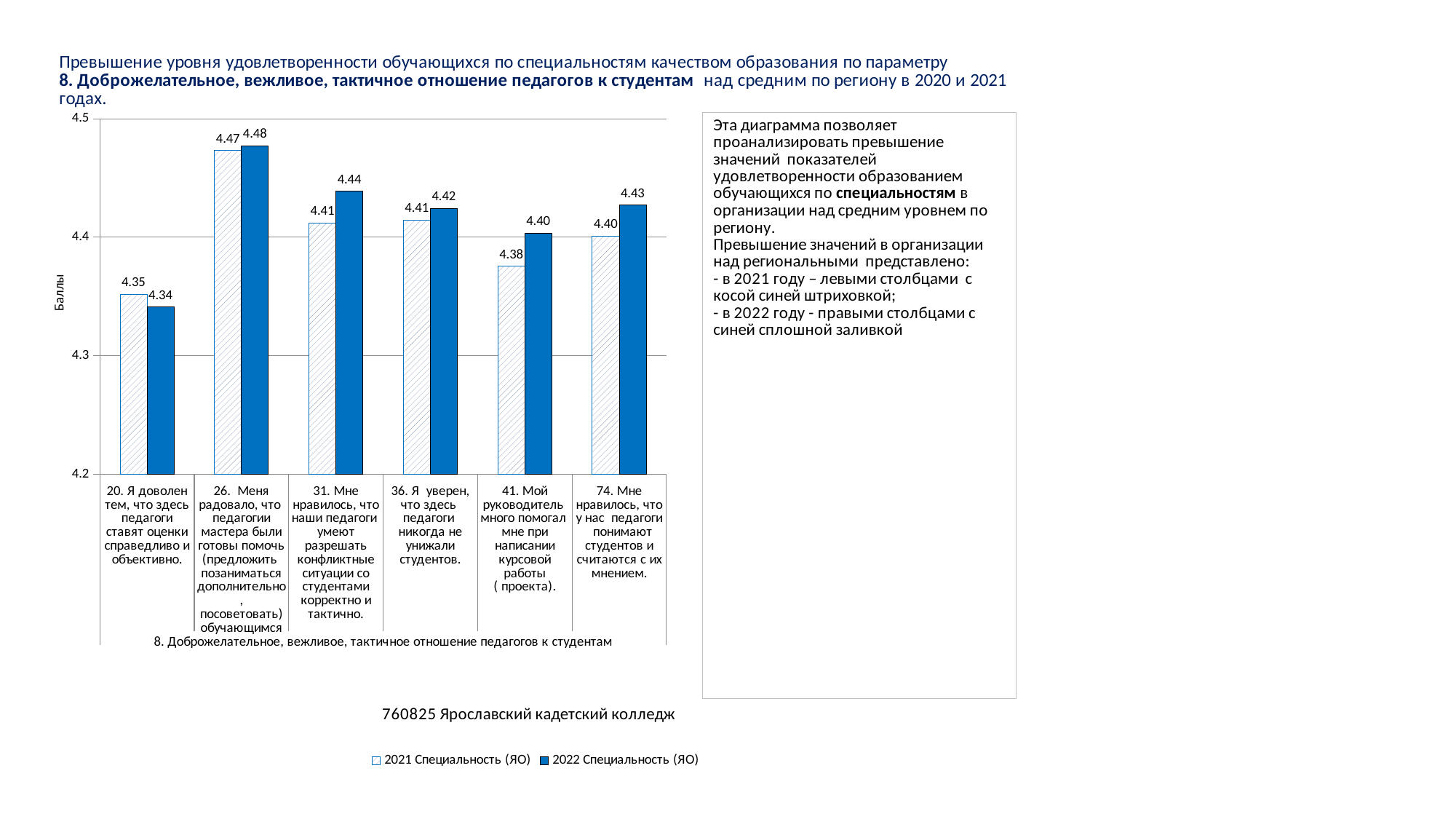
What is the difference between the 2022 and 2021 values for item 74 (Мне нравилось, что у нас педагоги понимают студентов)? 0.03 Which item has the lowest 2021 Специальность (ЯО) value? 20. Я доволен тем, что здесь педагоги ставят оценки справедливо и объективно How many series does the legend list? 2 For item 20, which is larger: the 2021 value or the 2022 value? 2021 (4.35) What kind of chart is shown on the slide? Bar chart Which item has the highest 2022 Специальность (ЯО) value? 26. Меня радовало, что педагоги мастера были готовы помочь How many items (categories) are shown on the x axis? 6 What is the label of the vertical axis? Баллы What is the 2022 Специальность (ЯО) value for item 31 (Мне нравилось, что наши педагоги умеют разрешать конфликтные ситуации...)? 4.44 What is the 2022 Специальность (ЯО) value for item 41 (Мой руководитель много помогал мне при написании курсовой работы)? 4.40 What is the 2021 Специальность (ЯО) value for item 20 (Я доволен тем, что здесь педагоги ставят оценки справедливо и объективно)? 4.35 Is the 2021 Специальность (ЯО) value for item 41 greater or less than 4.4? less